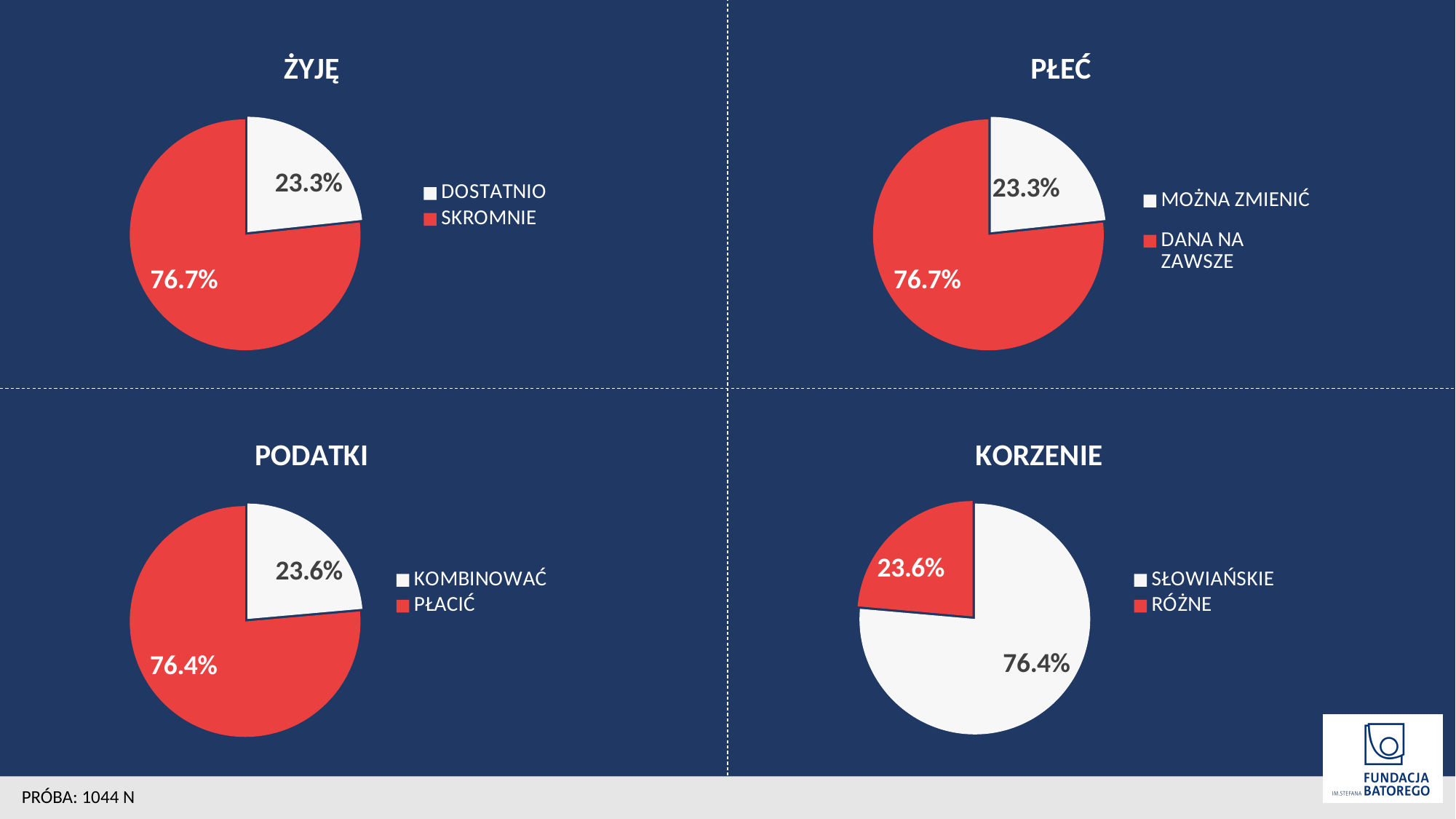
In the PŁEĆ chart, which slice is larger, MOŻNA ZMIENIĆ or DANA NA ZAWSZE? DANA NA ZAWSZE In the PODATKI chart, what is the difference between the PŁACIĆ and KOMBINOWAĆ shares? 52.8% In the KORZENIE chart, what share is labelled for RÓŻNE? 23.6% In the ŻYJĘ chart, what share is labelled for DOSTATNIO? 23.3% What type of chart is the ŻYJĘ chart? Pie chart In the PODATKI chart, what share is labelled for PŁACIĆ? 76.4% How many slices does the PŁEĆ chart have? 2 In the KORZENIE chart, which slice is the largest? SŁOWIAŃSKIE In the PODATKI chart, what share is labelled for KOMBINOWAĆ? 23.6% In the PŁEĆ chart, what share is labelled for MOŻNA ZMIENIĆ? 23.3% In the KORZENIE chart, what share is labelled for SŁOWIAŃSKIE? 76.4% In the ŻYJĘ chart, what share is labelled for SKROMNIE? 76.7%